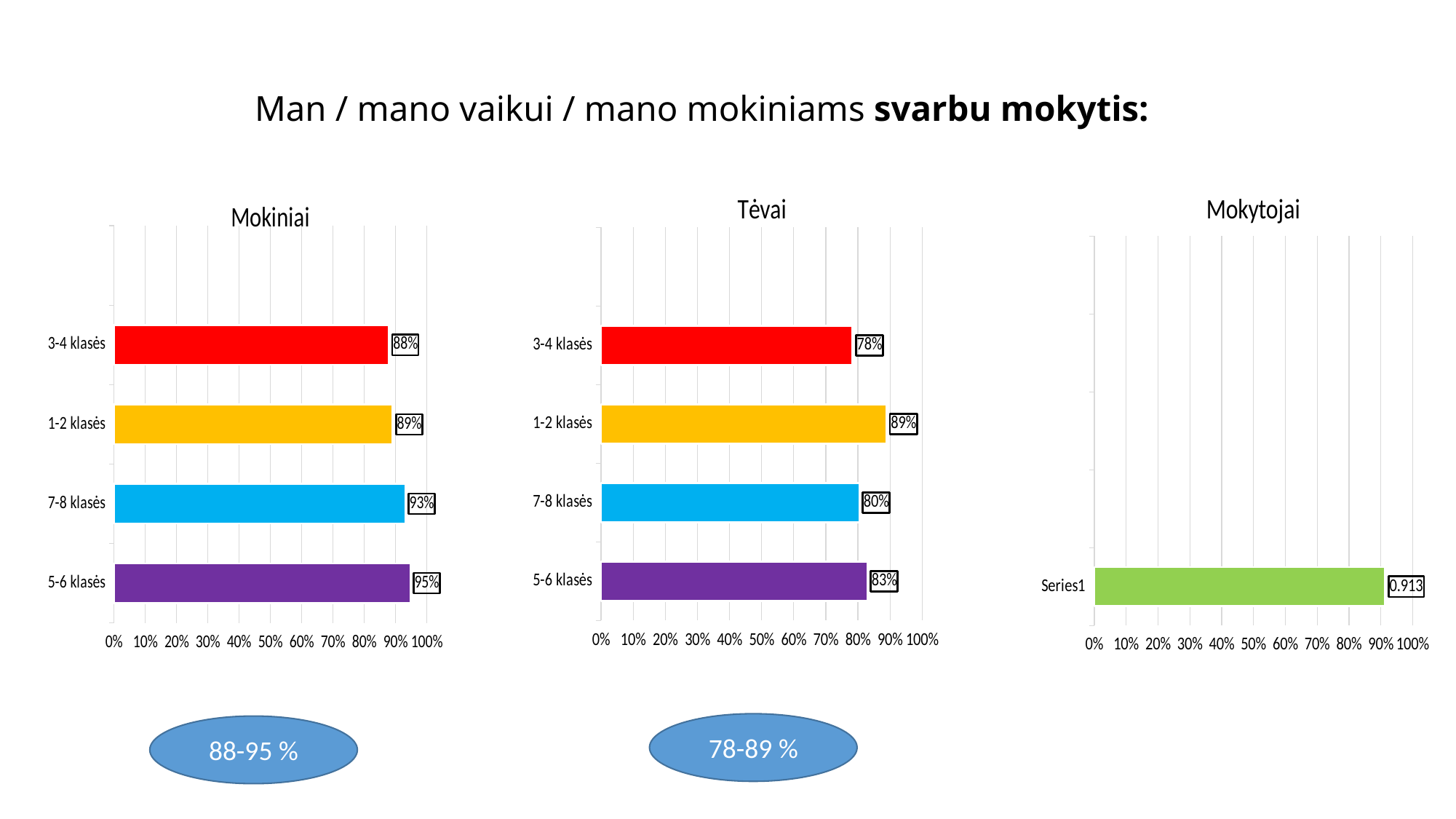
What kind of chart is the Mokytojai chart? bar chart In the Mokytojai chart, what is the value for Series1? 0.913 What is the title of the chart on the right of the slide? Mokytojai In the Tėvai chart, which is larger: the value for 5-6 klasės or the value for 3-4 klasės? 5-6 klasės In the Tėvai chart, which category has the lowest value? 3-4 klasės In the Mokiniai chart, which category has the highest value? 5-6 klasės In the Mokiniai chart, is the value for 3-4 klasės greater or less than 80%? greater How many categories are shown in the Tėvai chart? 4 In the Tėvai chart, what is the difference between the values for 1-2 klasės and 7-8 klasės? 9% In the Tėvai chart, what is the value for 1-2 klasės? 89% In the Mokiniai chart, what is the difference between the values for 5-6 klasės and 3-4 klasės? 7% In the Mokiniai chart, what is the value for 7-8 klasės? 93%